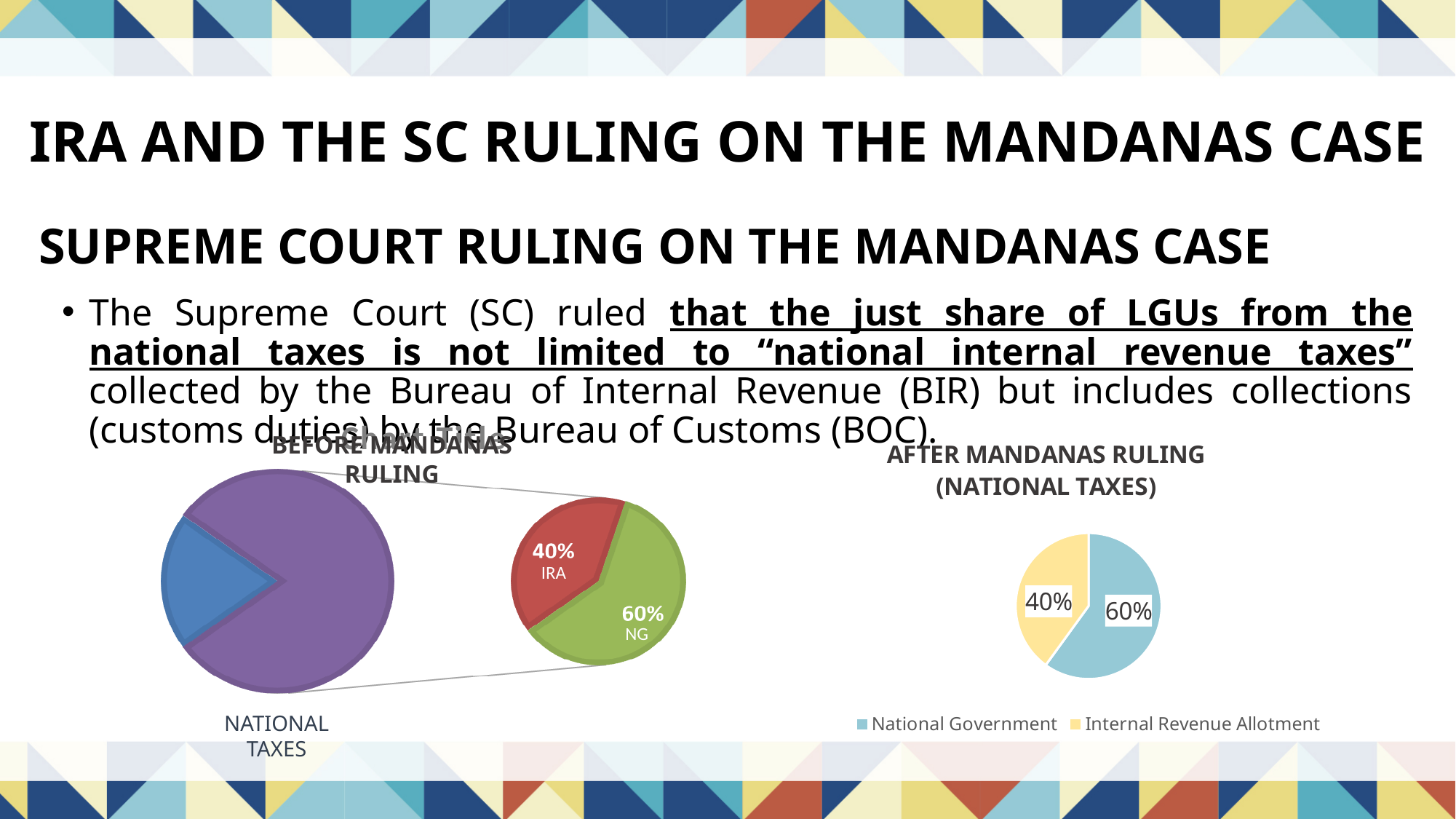
What type of chart is the AFTER MANDANAS RULING (NATIONAL TAXES) chart? Pie chart How many series does the legend of the AFTER MANDANAS RULING (NATIONAL TAXES) chart list? 2 In the BEFORE MANDANAS RULING chart, what is the difference between the NG and IRA percentages in the secondary pie? 20% In the BEFORE MANDANAS RULING chart, what is the label below the main pie? NATIONAL TAXES In the BEFORE MANDANAS RULING chart, which is larger in the secondary pie, IRA or NG? NG In the AFTER MANDANAS RULING (NATIONAL TAXES) chart, what share goes to the Internal Revenue Allotment? 40% In the BEFORE MANDANAS RULING chart, what percentage is labelled NG in the secondary pie? 60% In the AFTER MANDANAS RULING (NATIONAL TAXES) chart, what colour is the Internal Revenue Allotment slice? Yellow In the AFTER MANDANAS RULING (NATIONAL TAXES) chart, which slice is larger, National Government or Internal Revenue Allotment? National Government In the AFTER MANDANAS RULING (NATIONAL TAXES) chart, what share goes to the National Government? 60% In the AFTER MANDANAS RULING (NATIONAL TAXES) chart, what is the difference between the National Government share and the Internal Revenue Allotment share? 20% In the BEFORE MANDANAS RULING chart, what percentage is labelled IRA in the secondary pie? 40%